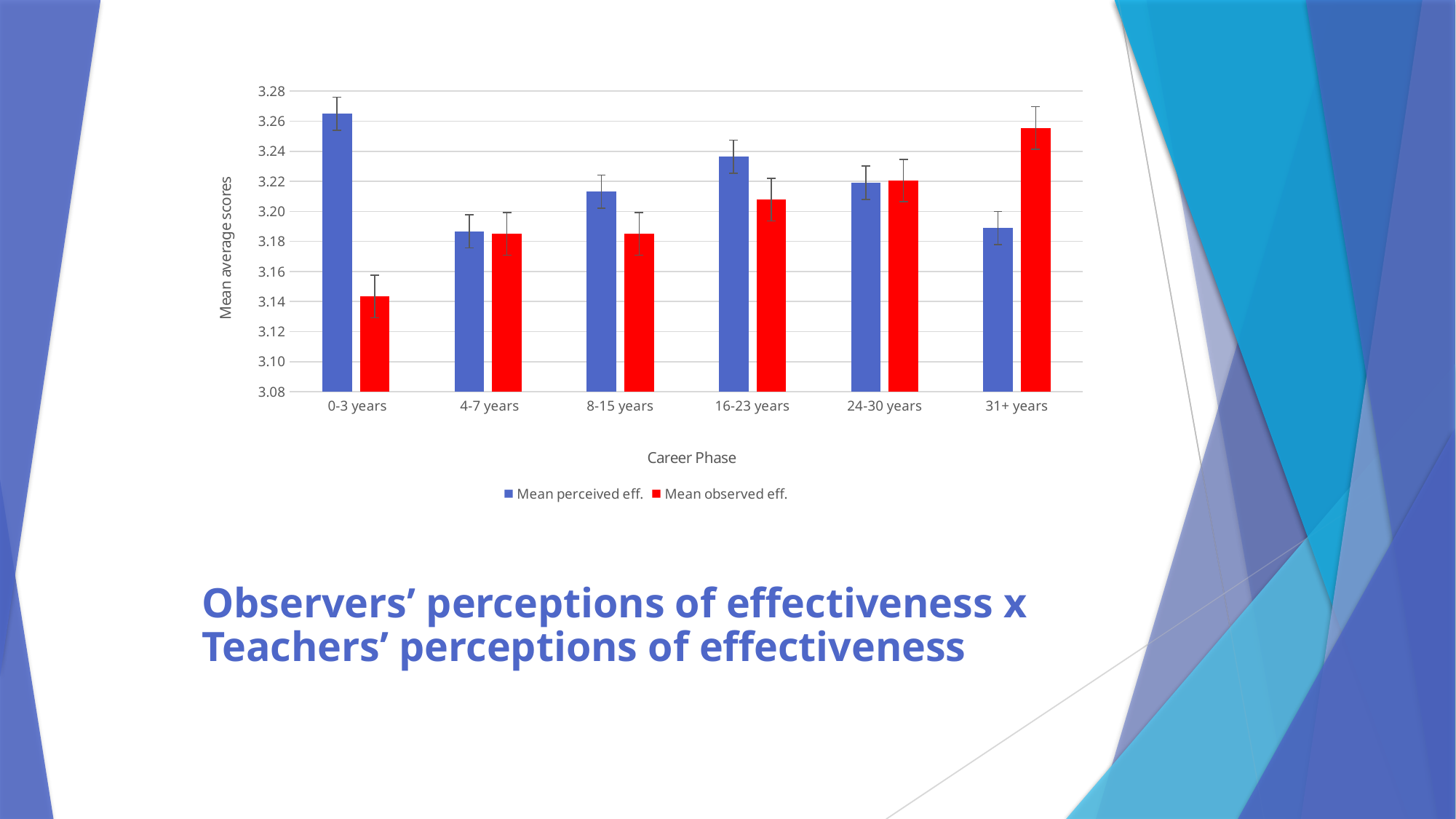
For 31+ years, which is larger: Mean perceived eff. or Mean observed eff.? Mean observed eff. Is the Mean observed eff. value for 0-3 years greater or less than 3.16? less Is the Mean observed eff. value for 31+ years greater or less than 3.24? greater For 16-23 years, which is larger: Mean perceived eff. or Mean observed eff.? Mean perceived eff. Which career phase has the highest Mean perceived eff. value? 0-3 years Which career phase has the highest Mean observed eff. value? 31+ years What kind of chart is shown on the slide? bar chart How many series does the legend list? 2 Is the Mean perceived eff. value for 0-3 years greater or less than 3.24? greater How many career phase categories are shown on the x axis? 6 What is the title of the vertical axis? Mean average scores Which career phase has the lowest Mean observed eff. value? 0-3 years